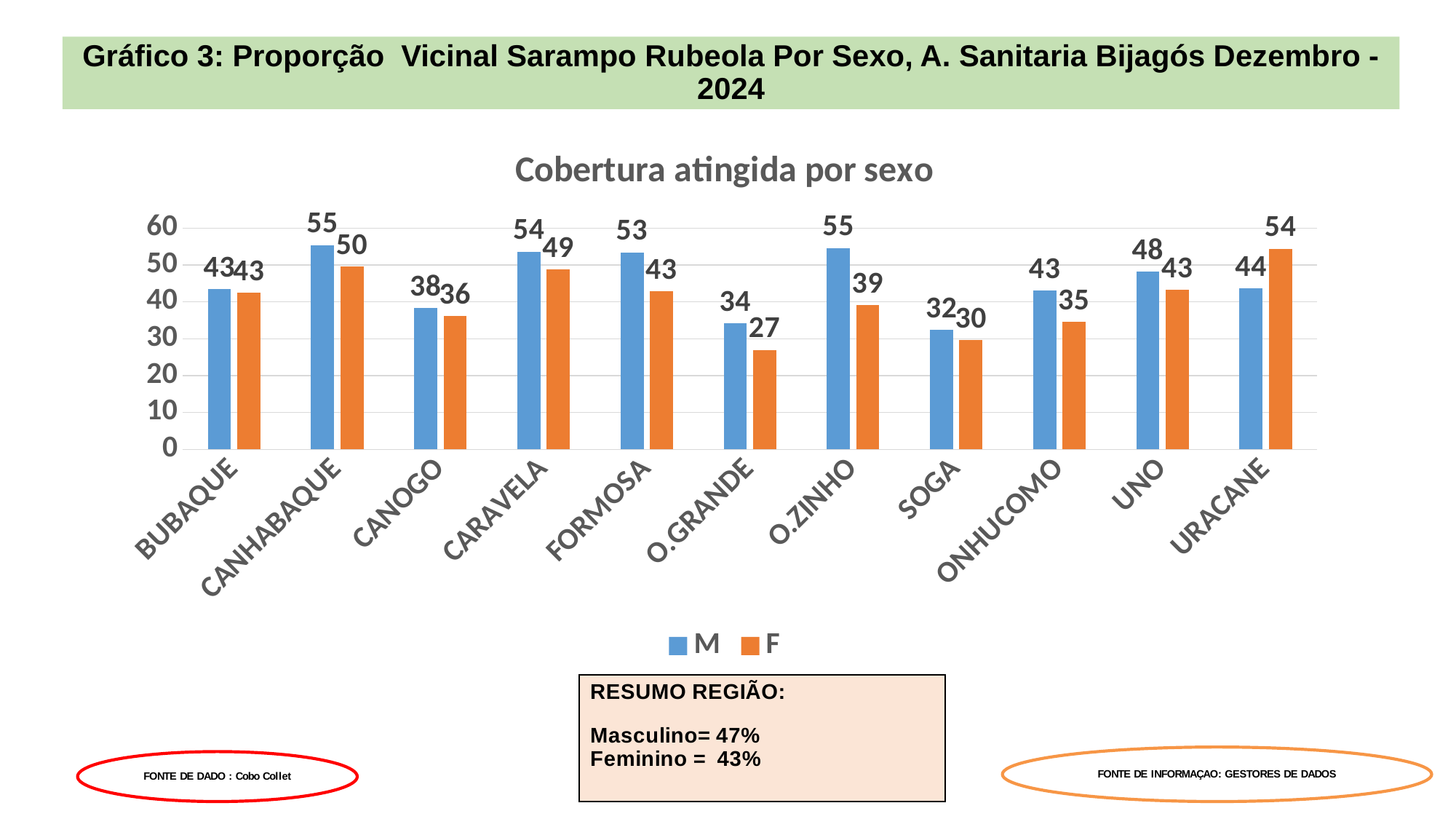
Which is larger for URACANE, the M value or the F value? F Which category has the lowest F value? O.GRANDE Which category has the highest F value? URACANE What is the difference between the M and F values for O.ZINHO? 16 What is the F value for O.ZINHO? 39 Which category has the lowest M value? SOGA What is the title of the chart? Cobertura atingida por sexo How many series does the legend list? 2 What is the M value for FORMOSA? 53 What kind of chart is shown? bar chart How many categories are shown on the x axis? 11 What is the F value for URACANE? 54